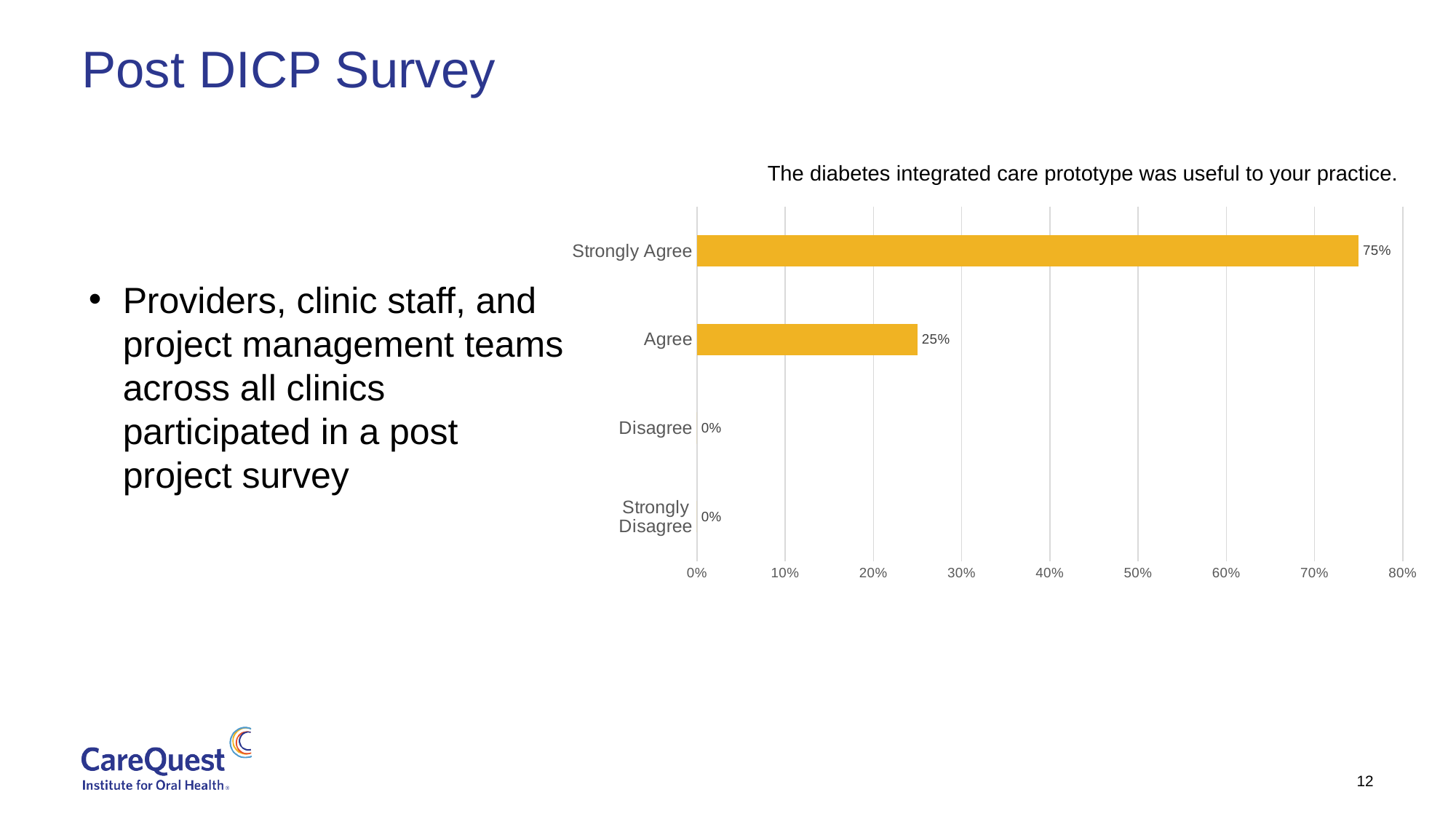
Is the value for Strongly Agree greater or less than 70%? greater What percentage of respondents answered Strongly Agree? 75% What percentage of respondents answered Agree? 25% Is the value for Agree greater or less than 30%? less Which is larger, the percentage for Agree or the percentage for Strongly Agree? Strongly Agree Which response category has the highest percentage? Strongly Agree What percentage of respondents answered Disagree? 0% What is the difference in percentage points between Strongly Agree and Agree? 50% How many response categories are shown on the chart? 4 What is the title of the chart? The diabetes integrated care prototype was useful to your practice. What percentage of respondents answered Strongly Disagree? 0% What type of chart is shown on the slide? Bar chart